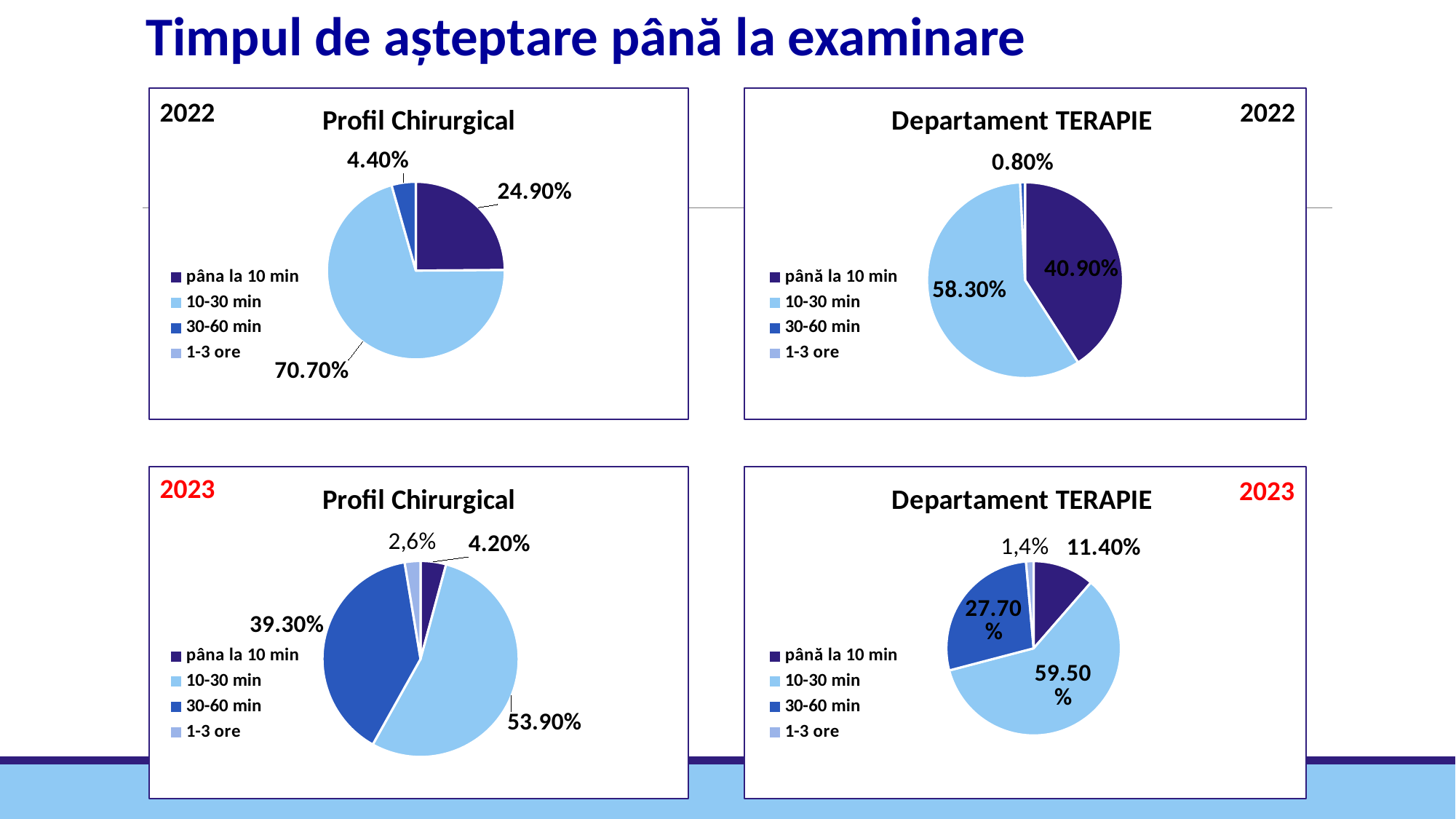
In the 2022 Profil Chirurgical chart, what share of the pie is the 10-30 min slice? 70.70% In the 2023 Profil Chirurgical chart, what is the value for 30-60 min? 39.30% In the 2022 Departament TERAPIE chart, what is the difference between the 10-30 min and până la 10 min slices? 17.40% In the 2022 Departament TERAPIE chart, what is the value for până la 10 min? 40.90% In the 2023 Departament TERAPIE chart, what is the value for 30-60 min? 27.70% In the 2023 Profil Chirurgical chart, which is larger: 10-30 min or 30-60 min? 10-30 min In the 2023 Departament TERAPIE chart, what is the difference between the 10-30 min and 30-60 min slices? 31.80% What type of chart is used in the 2022 Profil Chirurgical panel? Pie chart In the 2022 Profil Chirurgical chart, what is the value for 30-60 min? 4.40% How many entries does the legend of the 2023 Departament TERAPIE chart list? 4 In the 2023 Profil Chirurgical chart, which category has the smallest slice? 1-3 ore In the 2022 Departament TERAPIE chart, which category has the largest slice? 10-30 min